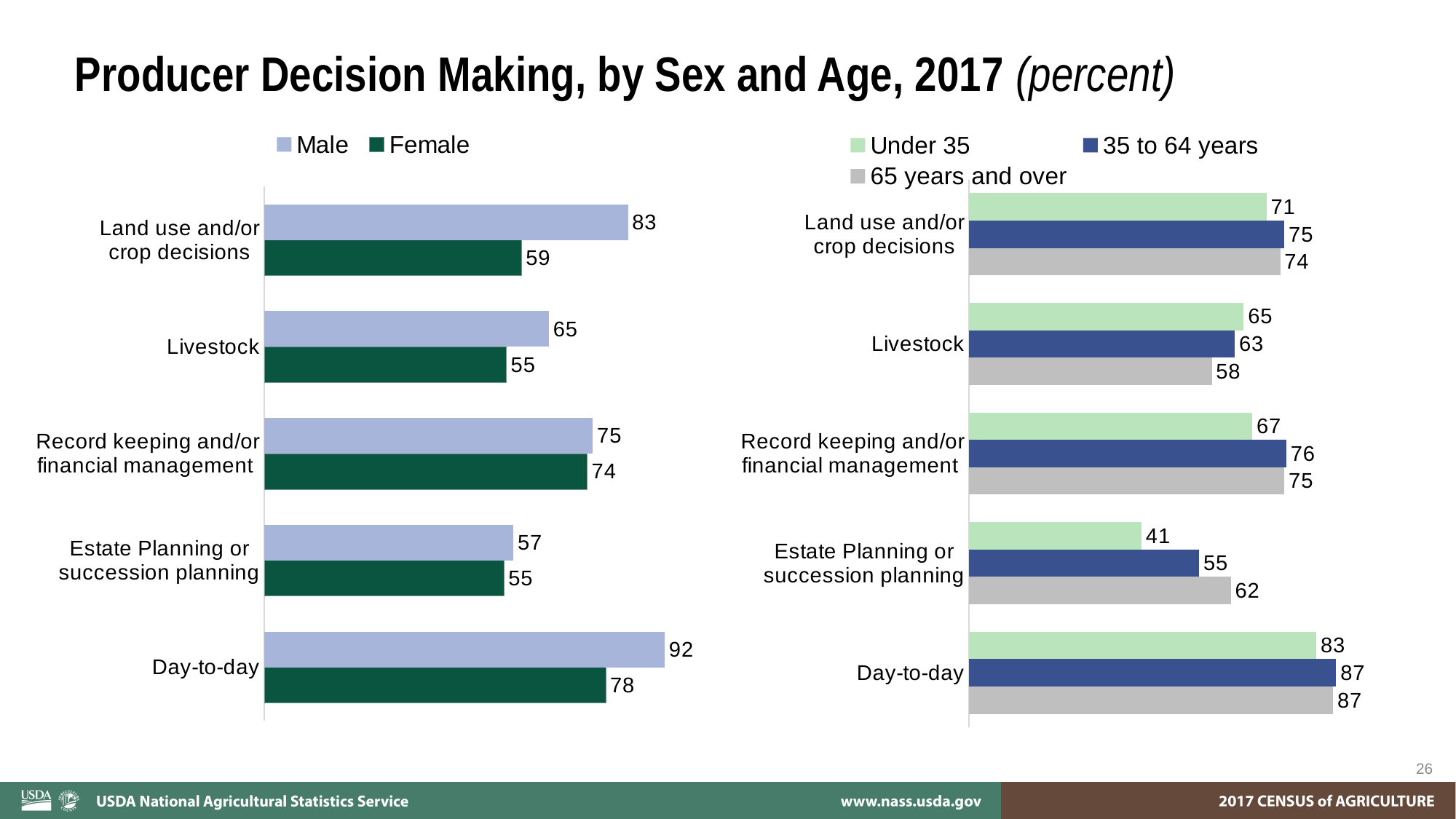
In the right chart (by age), what is the Under 35 value for Estate Planning or succession planning? 41 In the left chart (by sex), what is the Male value for Day-to-day? 92 What kind of chart is the left chart (by sex)? Bar chart In the left chart (by sex), what is the Female value for Land use and/or crop decisions? 59 How many series does the legend of the right chart (by age) list? 3 In the right chart (by age), which category has the lowest Under 35 value? Estate Planning or succession planning In the right chart (by age), which is larger for Livestock: the Under 35 value or the 65 years and over value? Under 35 In the left chart (by sex), which category has the highest Male value? Day-to-day In the right chart (by age), what is the 65 years and over value for Livestock? 58 In the right chart (by age), what is the difference between the 65 years and over and Under 35 values for Estate Planning or succession planning? 21 In the left chart (by sex), what is the difference between the Male and Female values for Land use and/or crop decisions? 24 How many categories are shown in the left chart (by sex)? 5